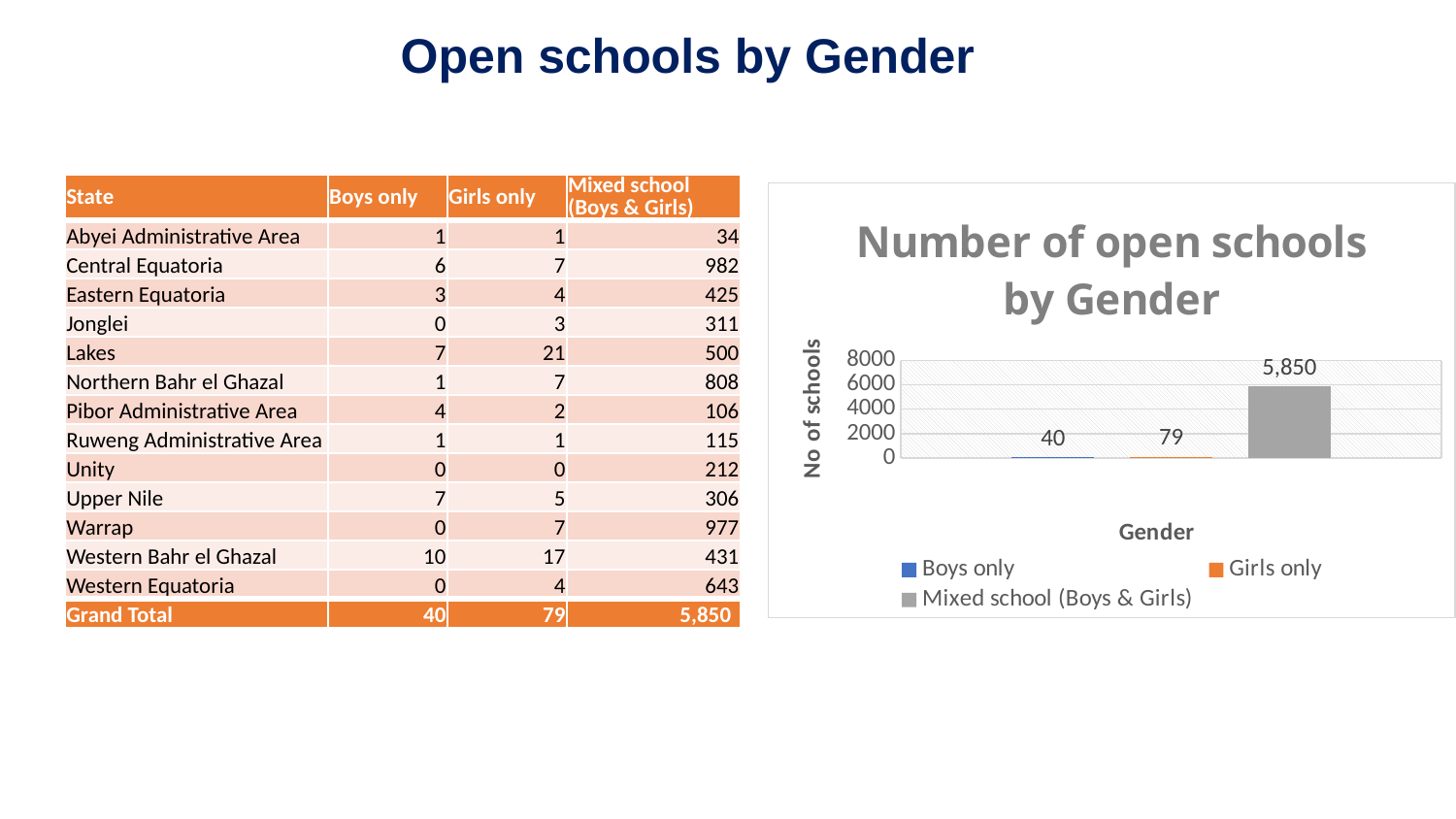
What is the label of the vertical axis of the chart? No of schools What type of chart is shown on the slide? bar chart What is the title of the chart? Number of open schools by Gender What is the difference between the Girls only and Boys only values in the chart? 39 Is the value for Mixed school (Boys & Girls) greater or less than 4000? greater How many series does the chart legend list? 3 What is the value shown for Boys only in the chart? 40 What is the value shown for Girls only in the chart? 79 Which is larger in the chart, Girls only or Boys only? Girls only Which series has the highest value in the chart? Mixed school (Boys & Girls) Which series has the lowest value in the chart? Boys only What is the value shown for Mixed school (Boys & Girls) in the chart? 5,850